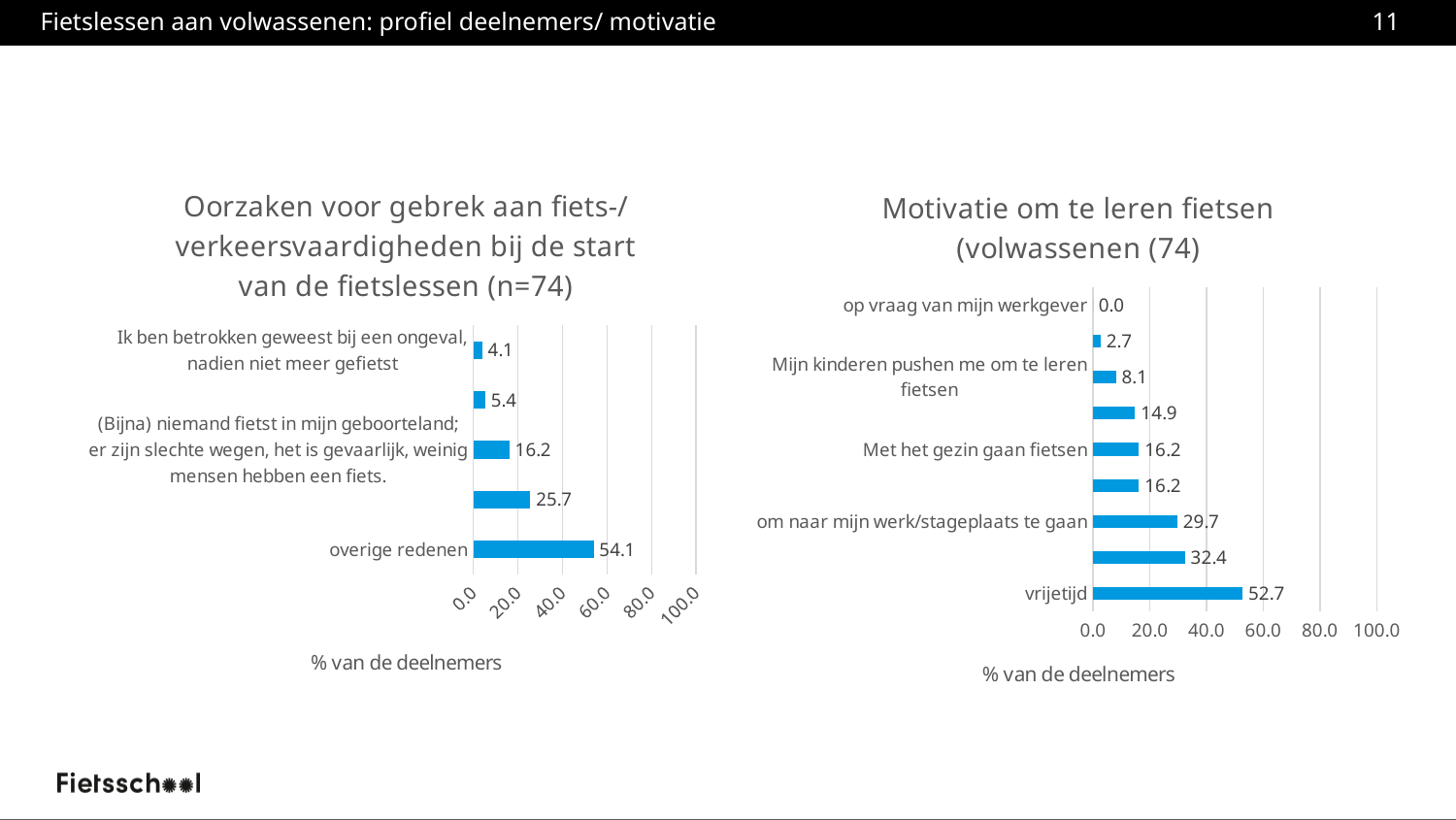
In the right chart (Motivatie om te leren fietsen), what is the value for "om naar mijn werk/stageplaats te gaan"? 29.7 In the right chart (Motivatie om te leren fietsen), what is the value for "vrijetijd"? 52.7 In the right chart (Motivatie om te leren fietsen), what is the value for "Mijn kinderen pushen me om te leren fietsen"? 8.1 In the left chart (Oorzaken voor gebrek aan fiets-/verkeersvaardigheden), what is the value for "(Bijna) niemand fietst in mijn geboorteland; er zijn slechte wegen, het is gevaarlijk, weinig mensen hebben een fiets."? 16.2 What type of chart is the right chart (Motivatie om te leren fietsen)? Bar chart In the right chart (Motivatie om te leren fietsen), what is the difference between the values for "vrijetijd" and "om naar mijn werk/stageplaats te gaan"? 23.0 In the left chart (Oorzaken voor gebrek aan fiets-/verkeersvaardigheden), what is the value for "overige redenen"? 54.1 In the right chart (Motivatie om te leren fietsen), which category has the lowest value? op vraag van mijn werkgever In the left chart (Oorzaken voor gebrek aan fiets-/verkeersvaardigheden), how many bars are plotted? 5 In the left chart (Oorzaken voor gebrek aan fiets-/verkeersvaardigheden), what is the value for "Ik ben betrokken geweest bij een ongeval, nadien niet meer gefietst"? 4.1 In the right chart (Motivatie om te leren fietsen), how many bars are plotted? 9 In the left chart (Oorzaken voor gebrek aan fiets-/verkeersvaardigheden), what is the highest value shown? 54.1